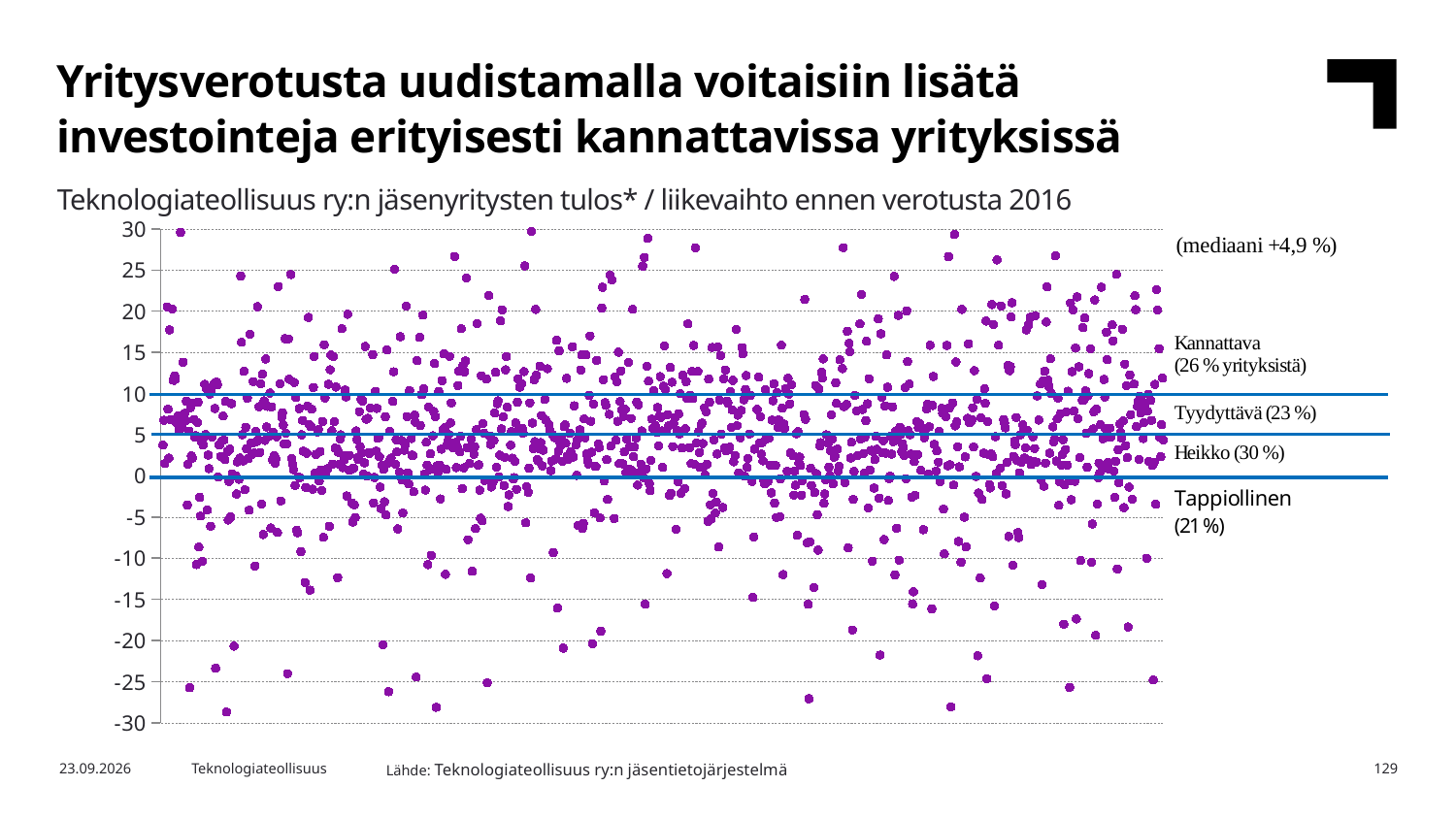
What is the difference in percentage points between the Heikko share and the Tappiollinen share? 9 What share of companies is labelled Tappiollinen? 21 % What share of companies is labelled Kannattava? 26 % Which of the four labelled groups has the largest share of companies? Heikko Which of the four labelled groups has the smallest share of companies? Tappiollinen What share of companies is labelled Heikko? 30 % What is the title of the chart? Teknologiateollisuus ry:n jäsenyritysten tulos* / liikevaihto ennen verotusta 2016 What are the highest and lowest values shown on the vertical axis? 30 and -30 What median value is stated on the chart? +4,9 % Which group has a larger share of companies, Kannattava or Tyydyttävä? Kannattava What kind of chart is shown on the slide? scatter chart What share of companies is labelled Tyydyttävä? 23 %